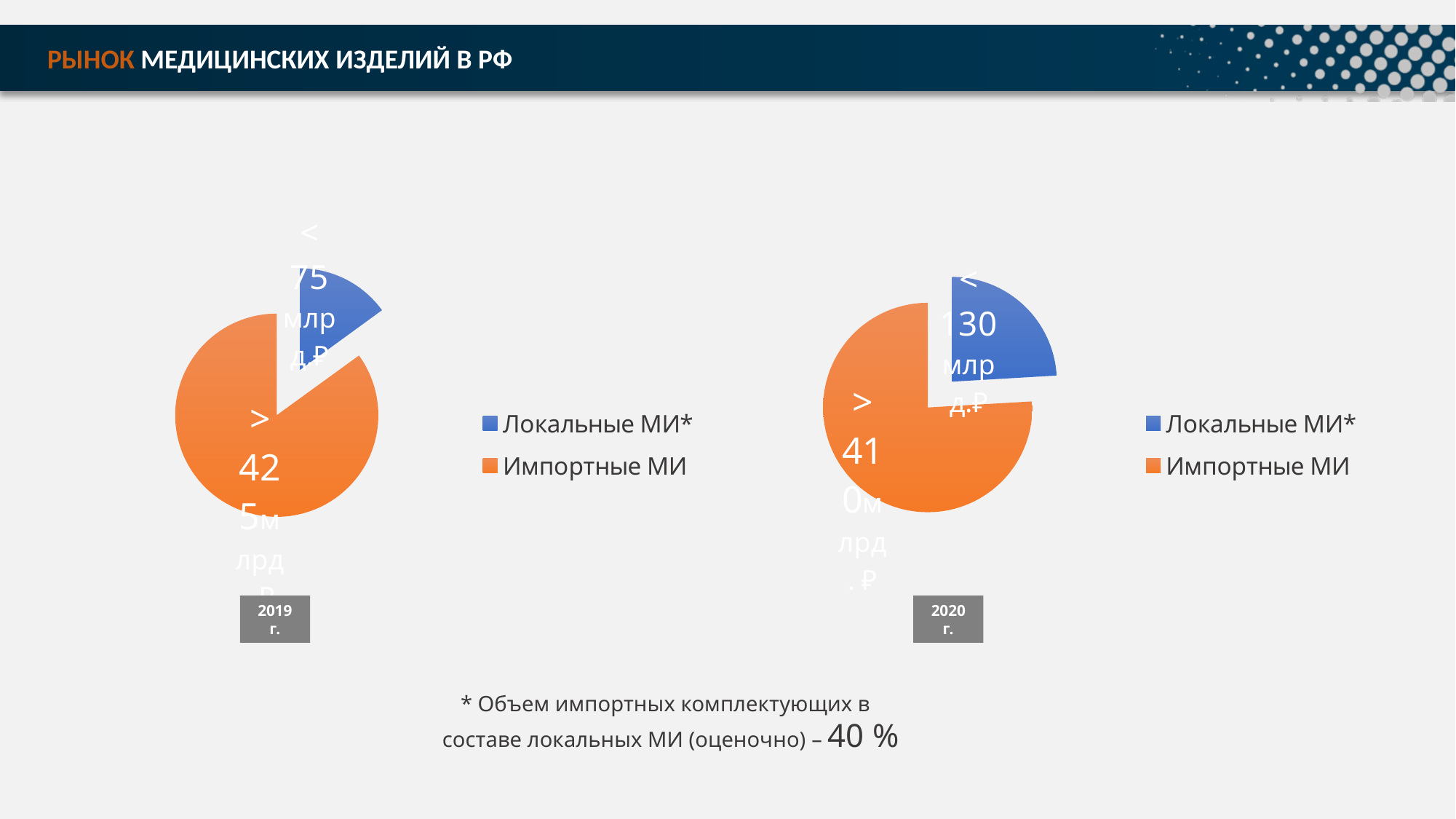
In the 2019 г. pie chart, what colour is the Импортные МИ slice? orange In the 2020 г. pie chart, how many slices are there? 2 In the 2020 г. pie chart, which category has the smallest slice? Локальные МИ* In the 2020 г. pie chart, what colour is the Локальные МИ* slice? blue How many entries does the legend of the 2019 г. chart list? 2 What kind of chart is the 2019 г. chart on the left? pie chart In the 2020 г. pie chart, which category has the largest slice? Импортные МИ In the 2019 г. pie chart, how many slices are there? 2 What kind of chart is the 2020 г. chart on the right? pie chart In the 2019 г. pie chart, which category has the largest slice? Импортные МИ In the 2019 г. pie chart, which category has the smallest slice? Локальные МИ* In the 2020 г. pie chart, which slice is larger: Локальные МИ* or Импортные МИ? Импортные МИ